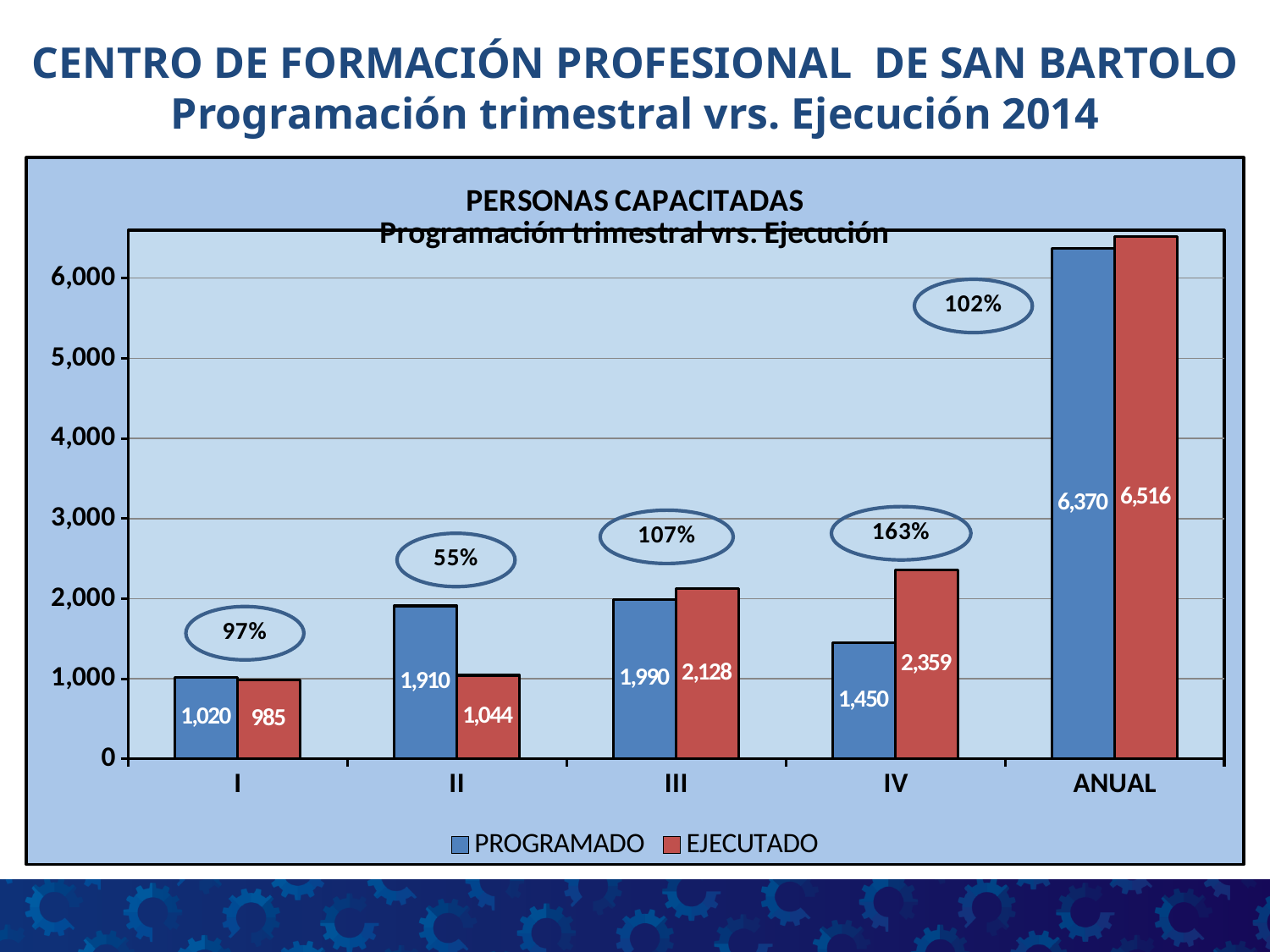
Which category has the highest PROGRAMADO value? ANUAL What is the difference between the EJECUTADO and PROGRAMADO values for quarter IV? 909 Which quarter (I to IV) has the lowest EJECUTADO value? I For quarter III, which is larger, PROGRAMADO or EJECUTADO? EJECUTADO For quarter I, which is larger, PROGRAMADO or EJECUTADO? PROGRAMADO What is the PROGRAMADO value for quarter II? 1,910 How many categories are shown on the x axis? 5 How many series does the legend list? 2 What is the difference between the PROGRAMADO and EJECUTADO values for quarter II? 866 What is the EJECUTADO value for ANUAL? 6,516 What type of chart is shown? Bar chart What is the EJECUTADO value for quarter IV? 2,359